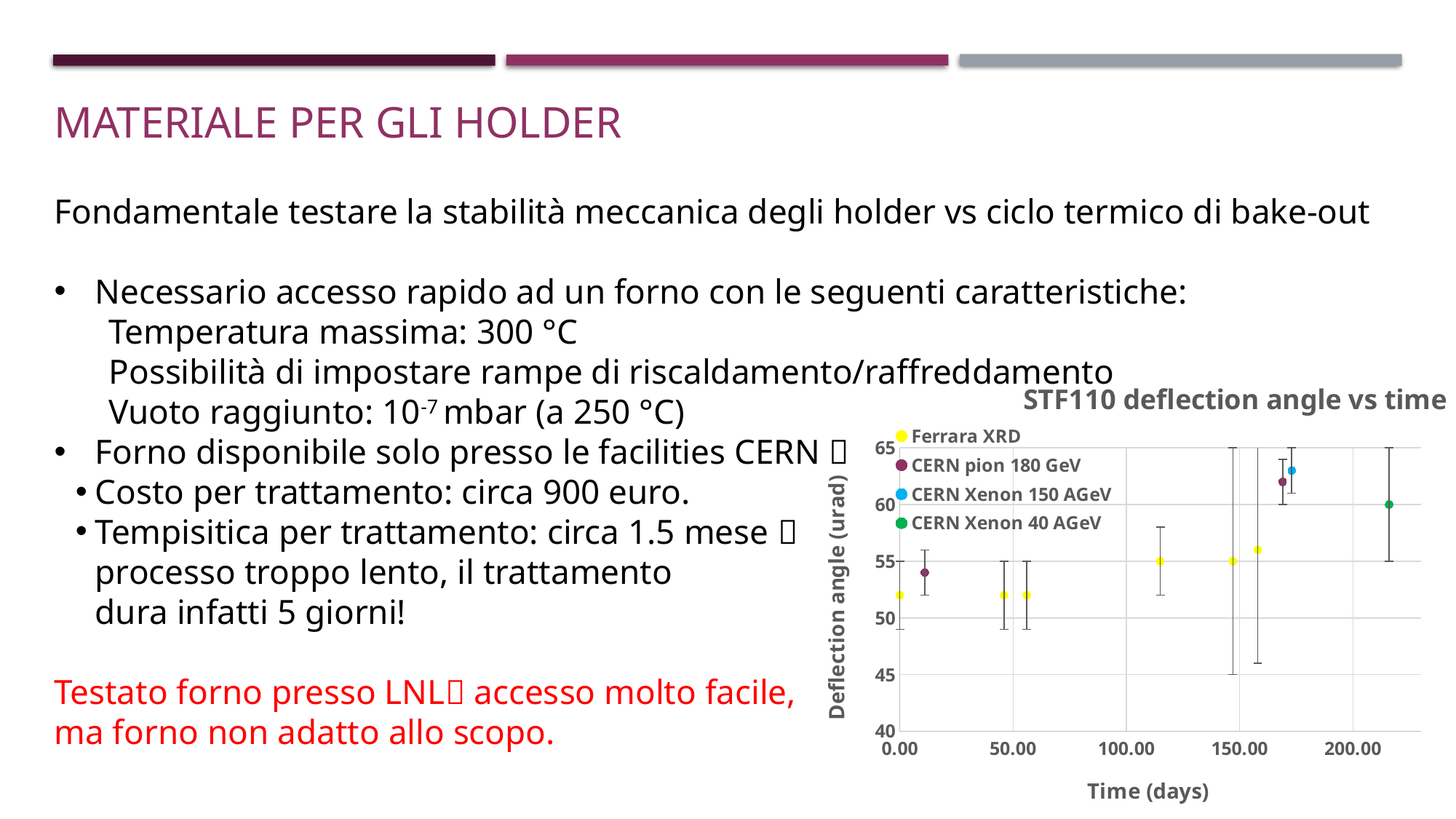
Which series has the points with the lowest deflection angle? Ferrara XRD Is the deflection angle for the Ferrara XRD point at time 0 greater or less than 55? less Is the deflection angle for the CERN Xenon 40 AGeV point greater or less than 55? greater Which series has the point with the highest deflection angle? CERN Xenon 150 AGeV What is the title of the chart on the slide? STF110 deflection angle vs time What kind of chart is shown on the slide? scatter chart Do the deflection angle values generally rise or fall as time increases? rise What is the label of the vertical axis of the chart? Deflection angle (urad) How many series does the chart legend list? 4 Which point has a larger deflection angle: CERN Xenon 150 AGeV or CERN Xenon 40 AGeV? CERN Xenon 150 AGeV How many Ferrara XRD points are plotted on the chart? 6 Is the deflection angle for the CERN Xenon 150 AGeV point greater or less than 60? greater